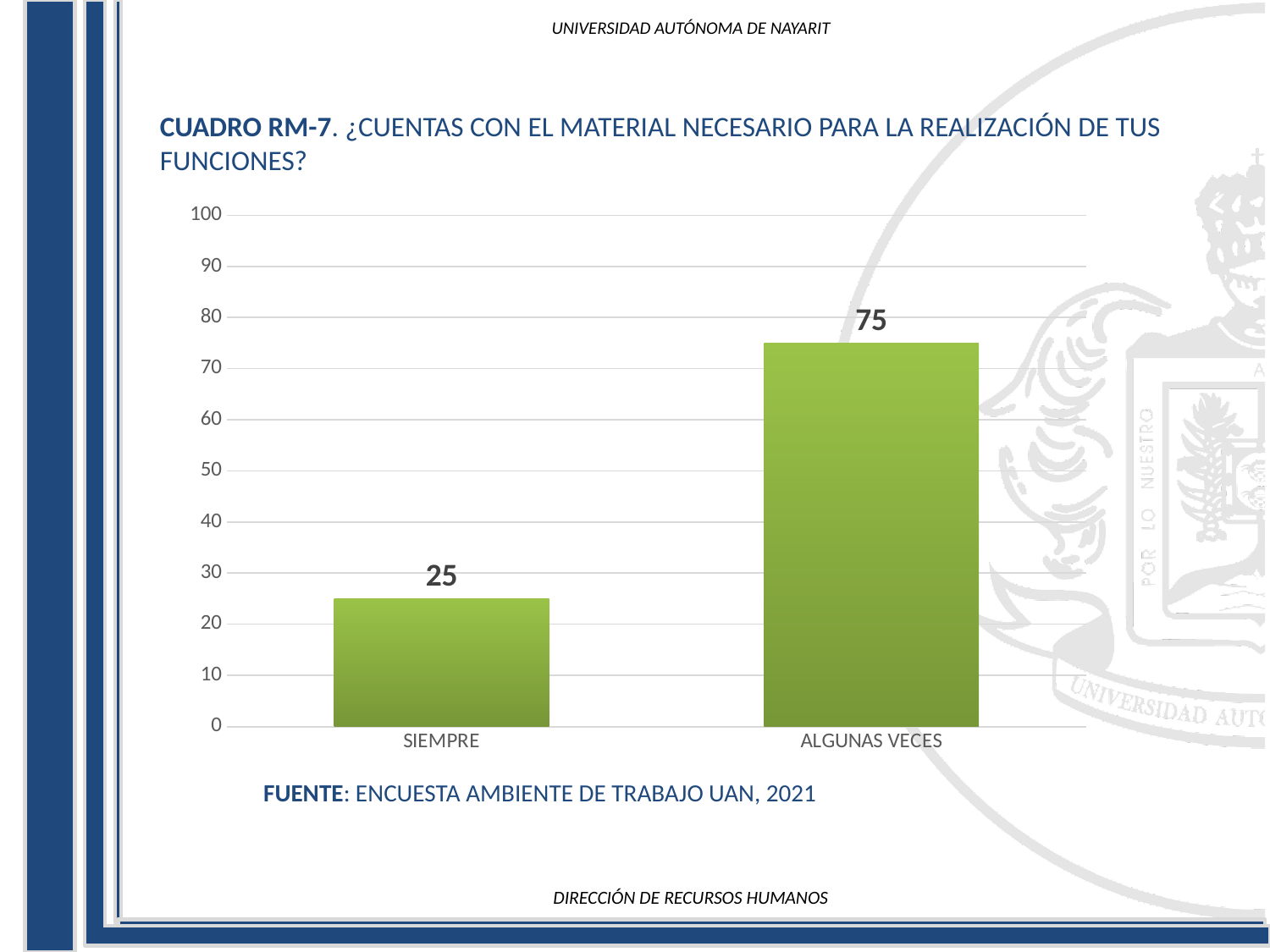
Is the value for SIEMPRE greater or less than 30? less Which is larger, the value for SIEMPRE or the value for ALGUNAS VECES? ALGUNAS VECES Which category has the lowest value? SIEMPRE What is the value for ALGUNAS VECES? 75 Which category has the highest value? ALGUNAS VECES What source is cited below the chart? ENCUESTA AMBIENTE DE TRABAJO UAN, 2021 What is the value for SIEMPRE? 25 What kind of chart is shown on the slide? bar chart What is the total of the two bar values? 100 What is the difference between the values for ALGUNAS VECES and SIEMPRE? 50 How many categories are shown on the x axis? 2 Is the value for ALGUNAS VECES greater or less than 70? greater